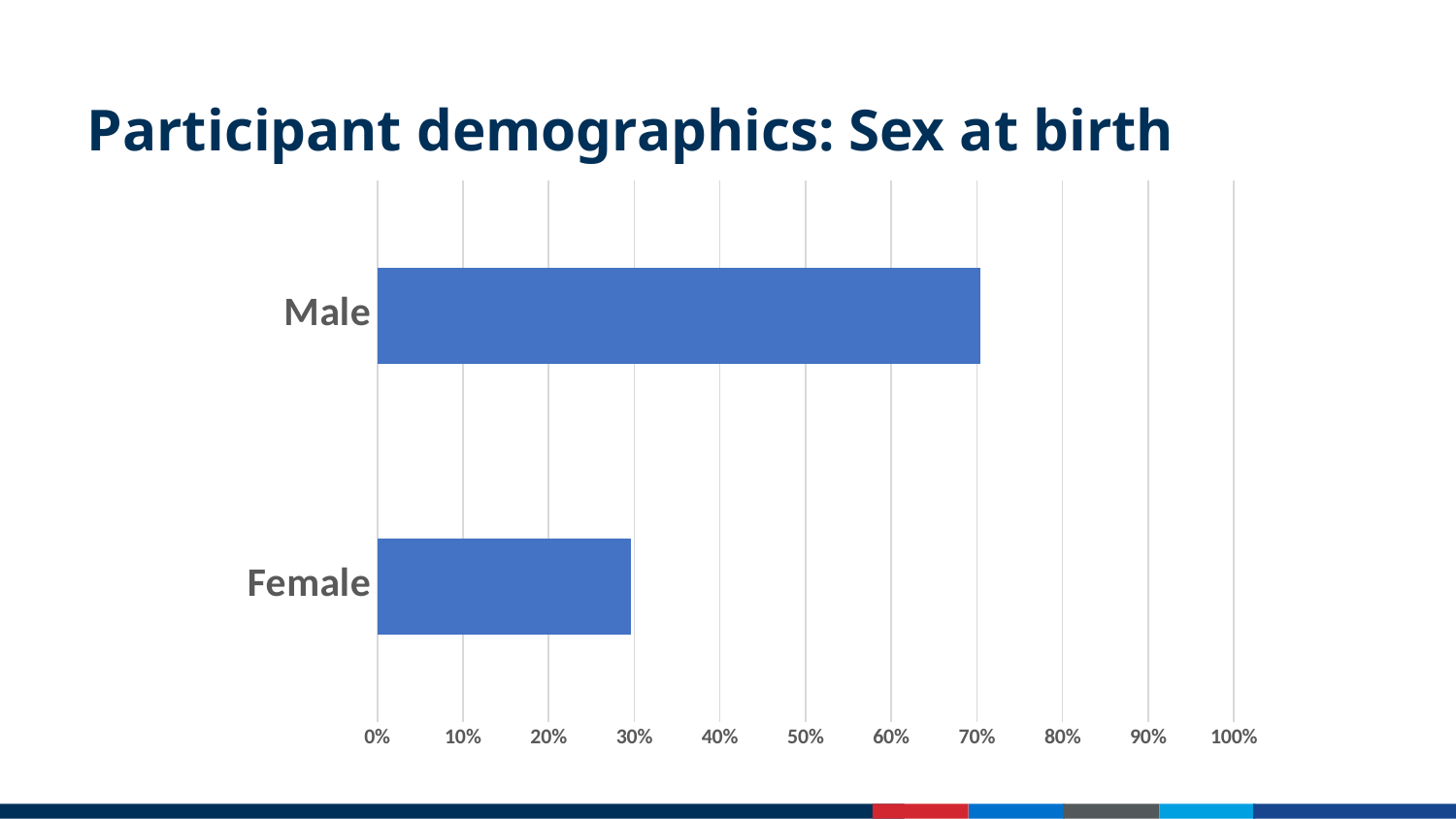
What kind of chart is shown on the slide? bar chart Which is larger, the value for Male or the value for Female? Male Is the value for Female greater or less than 40%? less Is the value for Female greater or less than 20%? greater How many categories are plotted in the chart? 2 Is the value for Male greater or less than 60%? greater Which category has the lowest value? Female What is the title of the chart on the slide? Participant demographics: Sex at birth Which category has the highest value? Male What is the maximum value shown on the horizontal axis? 100%